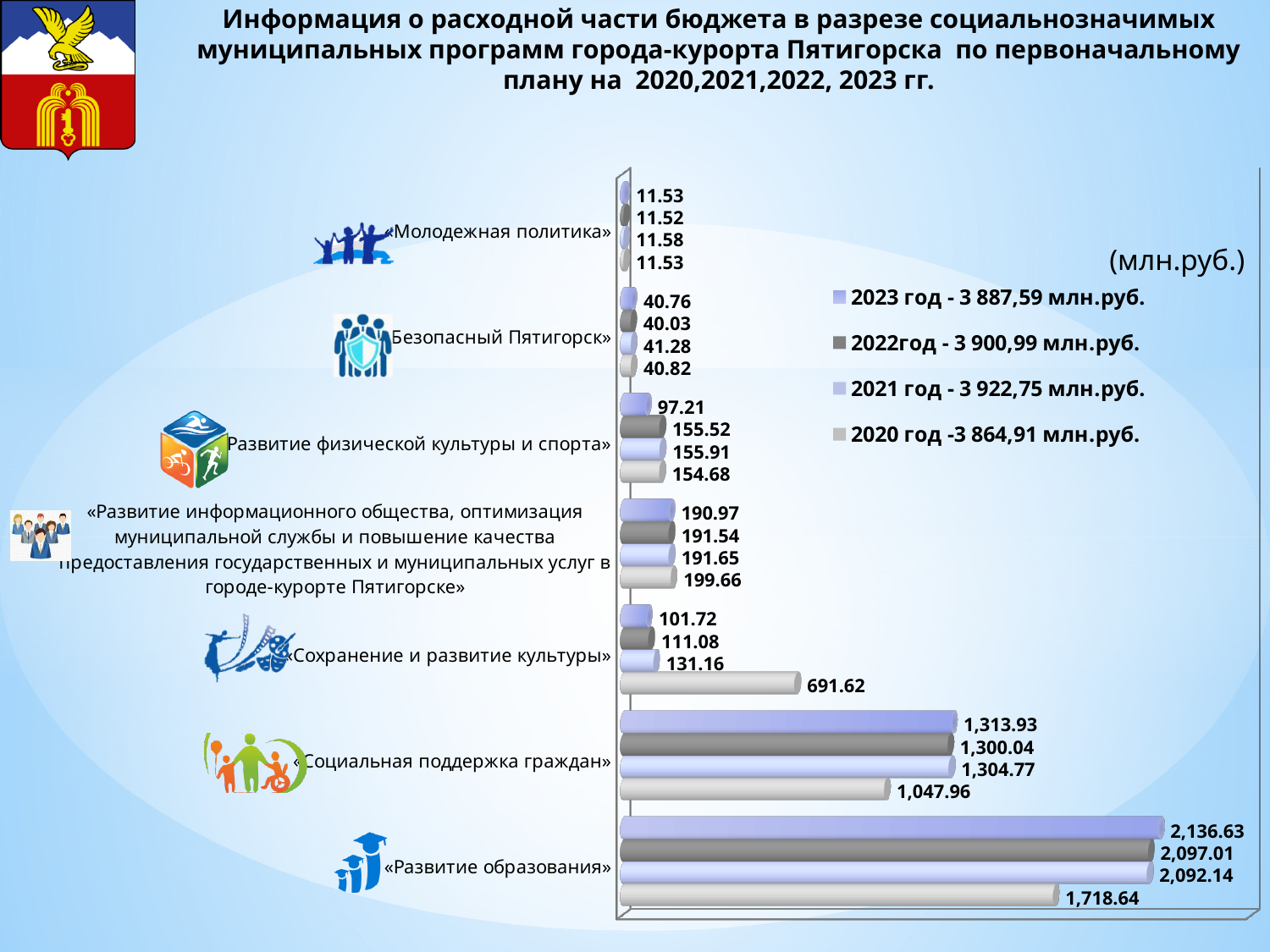
What is the value for «Развитие образования» in the 2023 series? 2,136.63 What is the difference between the 2020 and 2021 values for «Сохранение и развитие культуры»? 560.46 What is the value for «Сохранение и развитие культуры» in the 2020 series? 691.62 How many series does the legend list? 4 What kind of chart is shown on the slide? Bar chart What is the value for «Безопасный Пятигорск» in the 2021 series? 41.28 What is the value for «Социальная поддержка граждан» in the 2020 series? 1,047.96 For «Развитие физической культуры и спорта», which is larger: the 2023 value or the 2022 value? 2022 How many categories (programs) are shown on the chart? 7 Which category has the highest value in the 2022 series? «Развитие образования» Which category has the lowest value in the 2023 series? «Молодежная политика» What is the difference between the 2023 and 2020 values for «Развитие образования»? 417.99